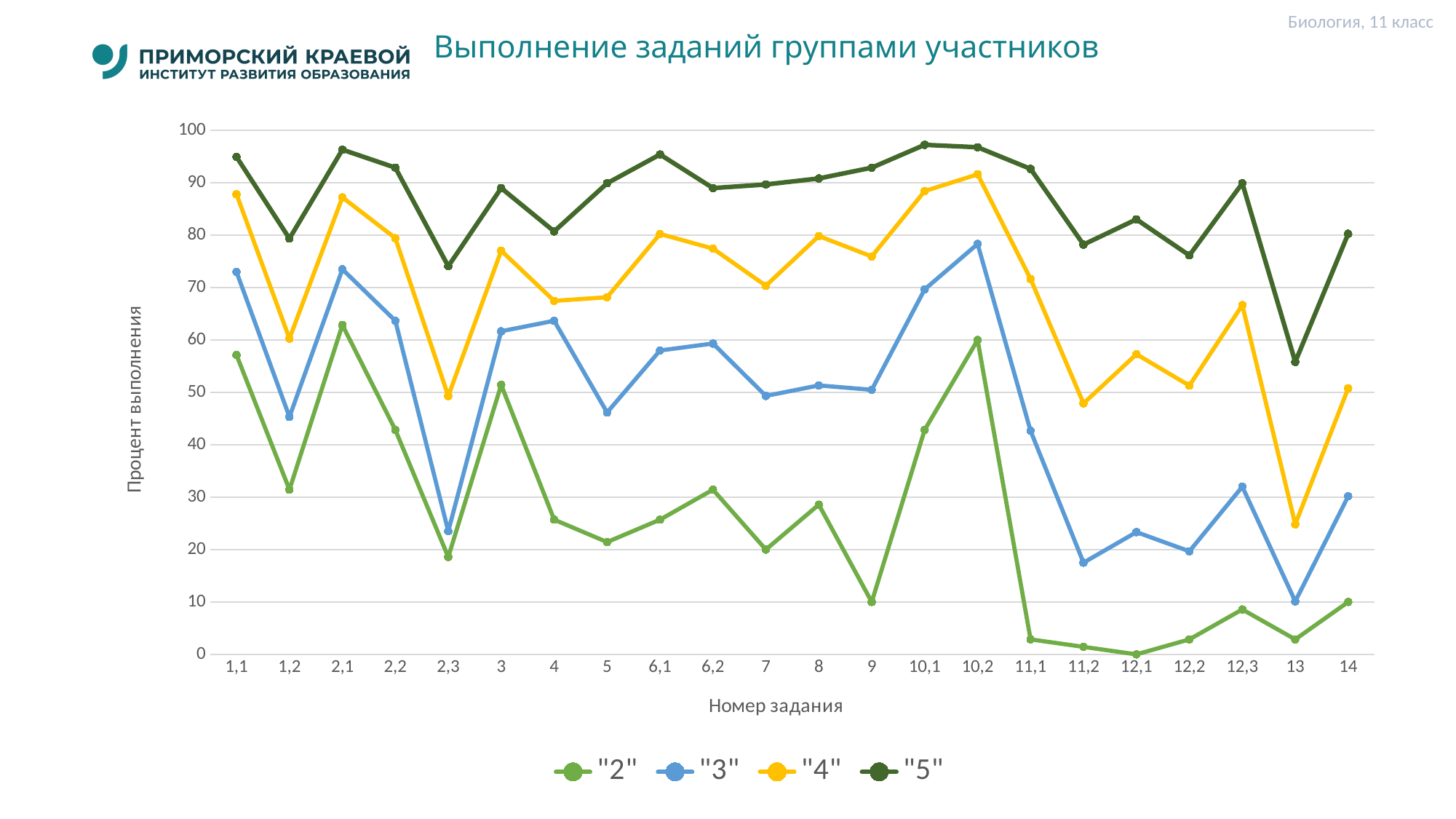
How many series does the legend list? 4 What is the label of the vertical axis? Процент выполнения Is the value for series "3" at task 10,2 greater or less than 70? greater At which task number does series "3" have its lowest value? 13 Is the value for series "2" at task 11,1 greater or less than 10? less Is the value for series "5" at task 1,1 greater or less than 90? greater How many task numbers are shown along the x axis? 22 At task 14, which series has the larger value, "4" or "3"? "4" What is the value for series "2" at task 12,1? 0 What is the title of the chart? Выполнение заданий группами участников At which task number does series "4" reach its highest value? 10,2 What kind of chart is shown on the slide? line chart